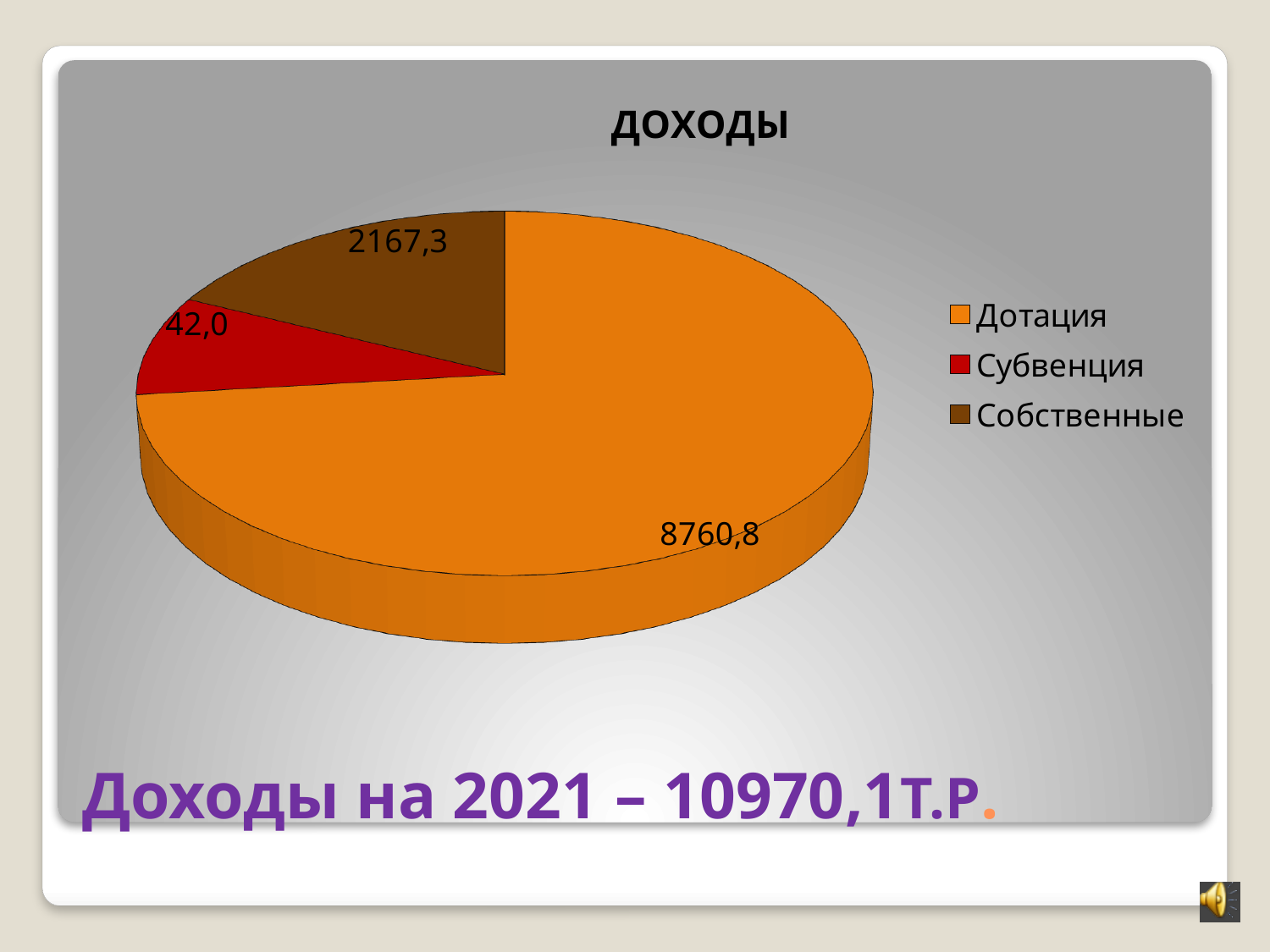
What is the difference between the values for Собственные and Субвенция? 2125,3 What is the value for Собственные? 2167,3 Which category has the largest slice of the pie? Дотация What colour is the slice for Субвенция? red What type of chart is shown on the slide? pie chart Which is larger, the value for Собственные or the value for Субвенция? Собственные What is the difference between the values for Дотация and Собственные? 6593,5 How many categories does the pie chart show? 3 What is the title of the chart? ДОХОДЫ Which category has the smallest slice of the pie? Субвенция What is the value for Дотация? 8760,8 What is the value for Субвенция? 42,0